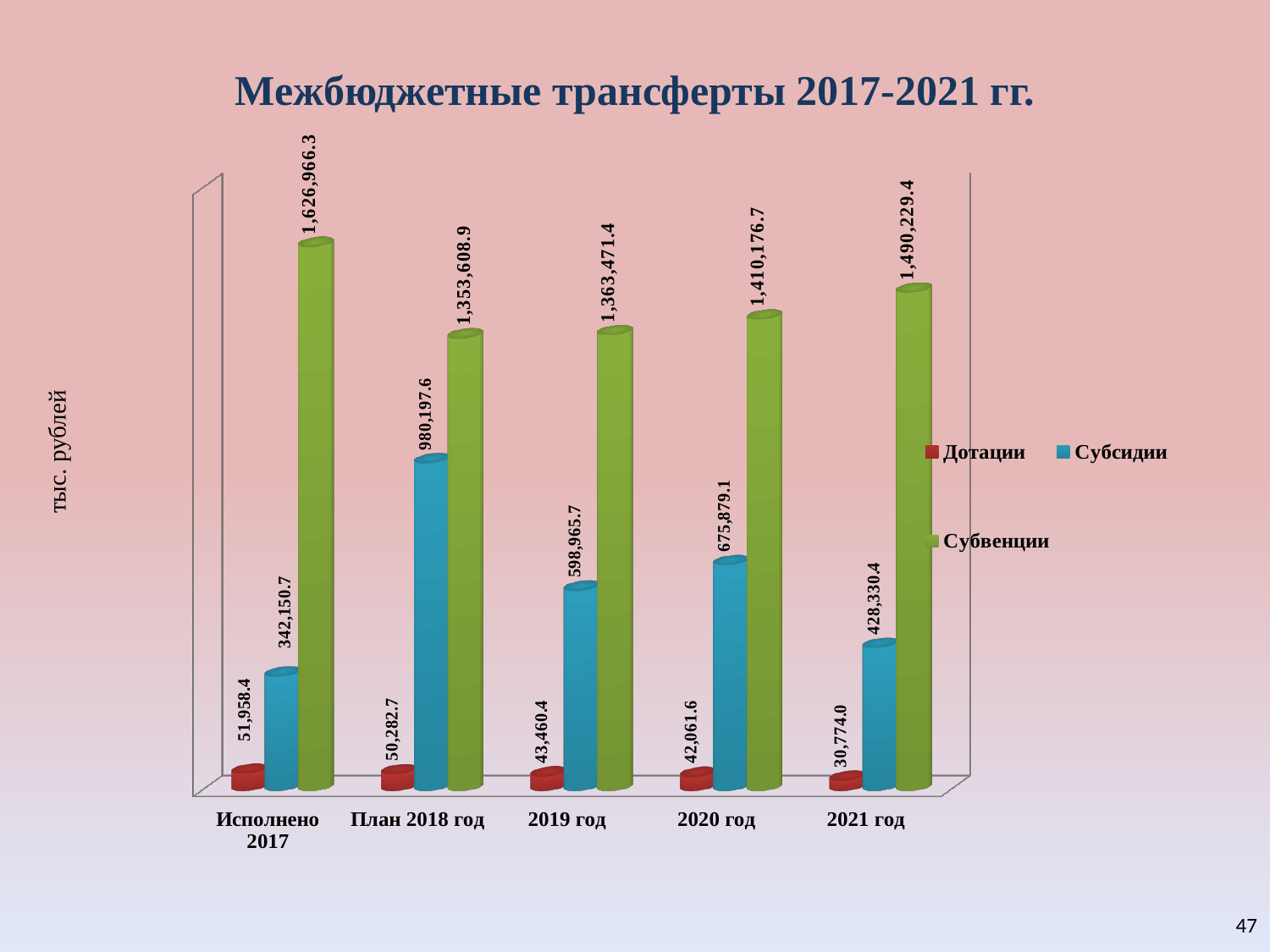
In which category is Субсидии highest? План 2018 год In which category is Субвенции lowest? План 2018 год What is the value of Субсидии for План 2018 год? 980,197.6 What is the difference between Субсидии for 2020 год and 2019 год? 76,913.4 How many series does the legend list? 3 What is the difference between Дотации for Исполнено 2017 and 2021 год? 21,184.4 What kind of chart is shown on the slide? bar chart What is the value of Субвенции for Исполнено 2017? 1,626,966.3 Which is larger: Субвенции for 2020 год or Субвенции for 2021 год? 2021 год Do the values for Дотации rise or fall from Исполнено 2017 to 2021 год? fall How many categories are shown on the x axis? 5 What is the value of Дотации for 2021 год? 30,774.0